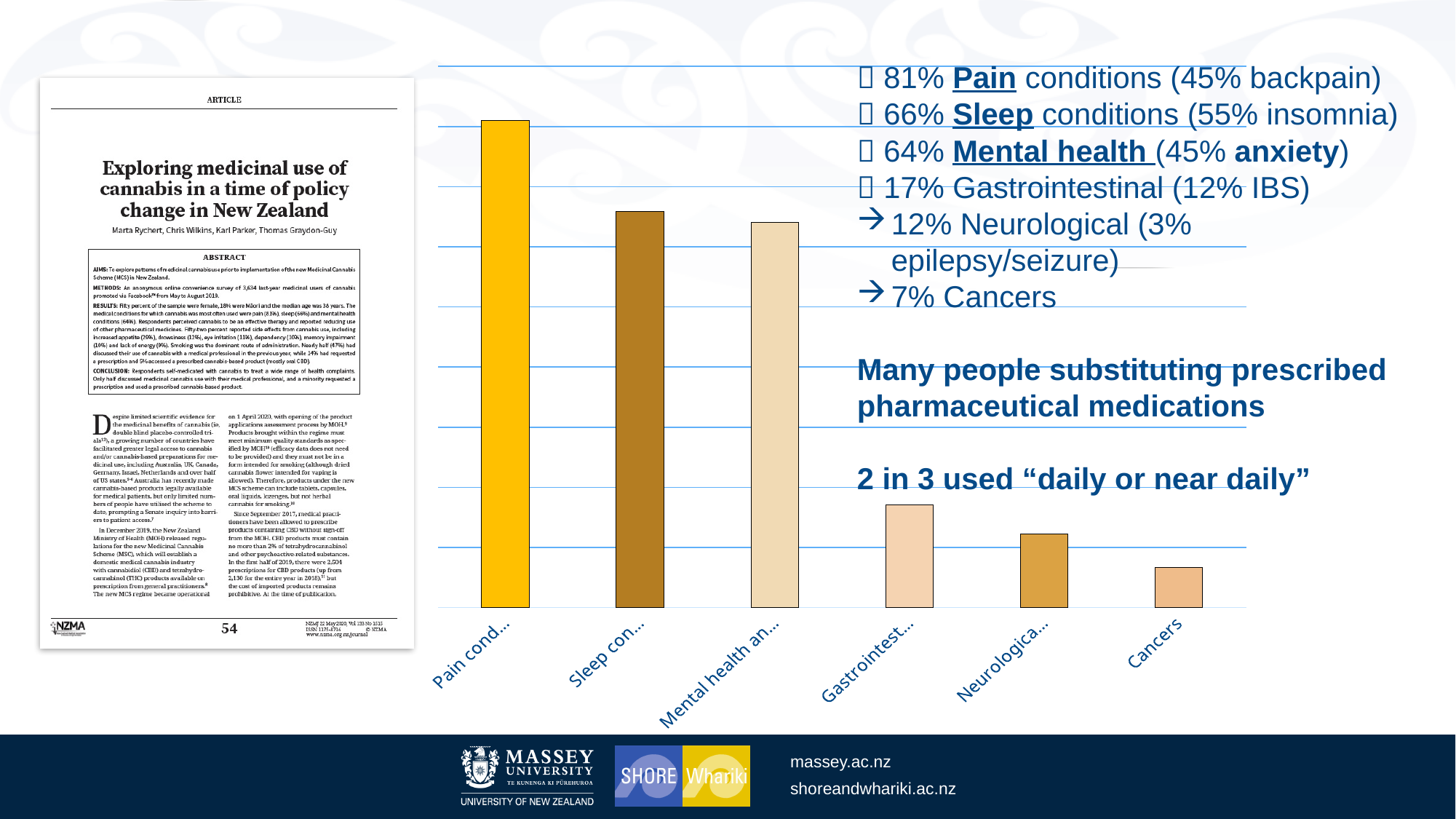
Is the bar for Pain conditions taller or shorter than the bar for Sleep conditions? taller Is the bar for Gastrointestinal taller or shorter than the bar for Neurological? taller Which category has the shortest bar in the chart? Cancers According to the slide, what percentage is shown for Pain conditions? 81% What kind of chart is shown on the slide? bar chart What colour is the bar for Pain conditions? yellow Do the bar heights rise or fall moving from left to right across the chart? fall How many categories (bars) does the chart show? 6 According to the slide, what percentage is shown for Cancers? 7% Which category has the tallest bar in the chart? Pain conditions Which category is plotted first (leftmost) on the x axis? Pain conditions Is the bar for Neurological taller or shorter than the bar for Cancers? taller